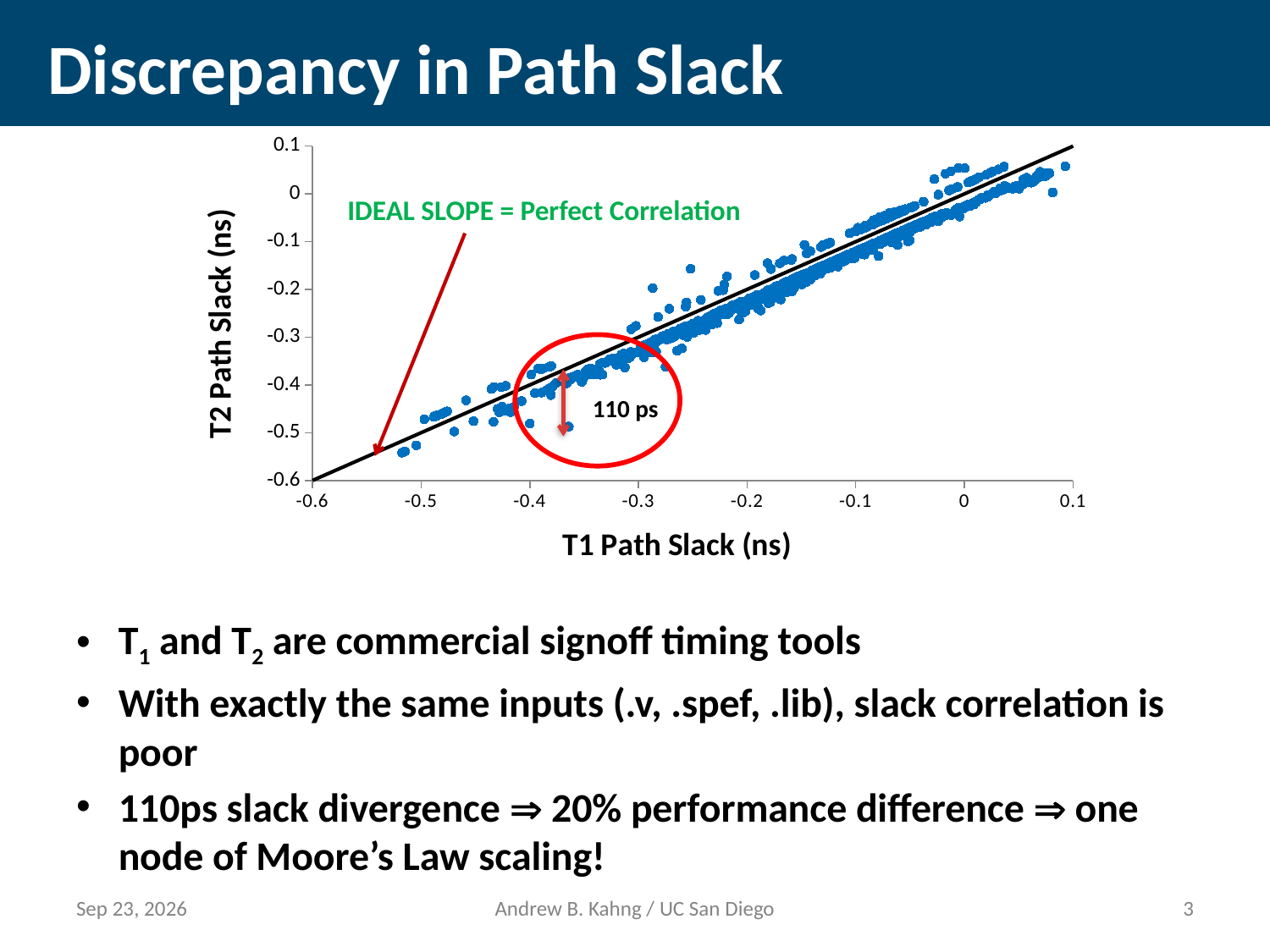
Is the T2 Path Slack value for the points near T1 Path Slack = -0.5 greater or less than -0.4 ns? less What is the label of the x axis? T1 Path Slack (ns) What does the green label say the black line represents? IDEAL SLOPE = Perfect Correlation Are the plotted points in the red circle above or below the ideal slope line? below What is the highest value shown on the x axis (T1 Path Slack)? 0.1 Do the plotted T2 Path Slack values rise or fall as T1 Path Slack increases along the x axis? rise What is the lowest value shown on the y axis (T2 Path Slack)? -0.6 What slack divergence is labelled inside the red circle on the chart? 110 ps What kind of chart is shown on the slide? scatter plot